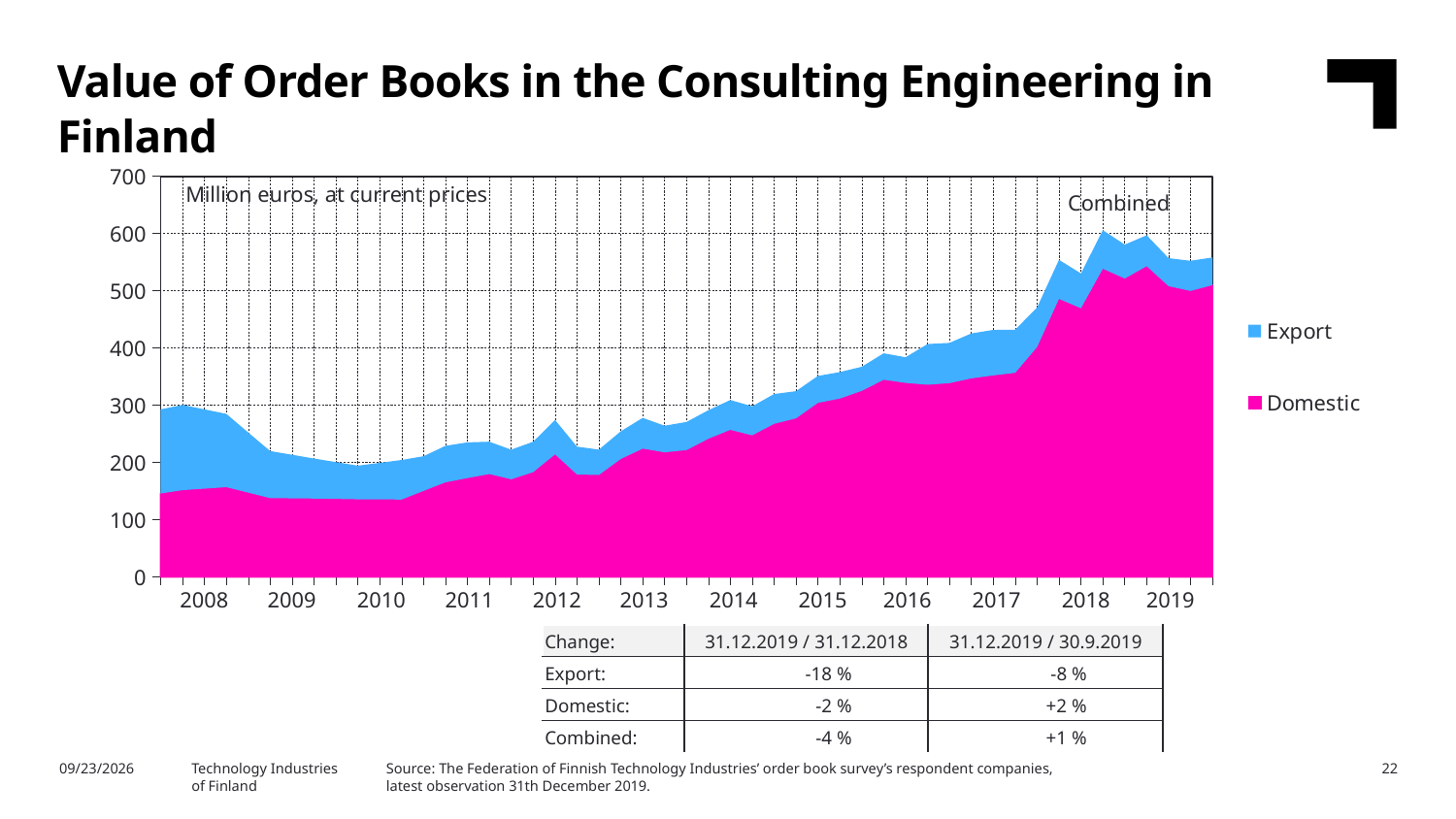
Is the combined value at its 2018 peak greater or less than 500? greater What unit is stated in the chart's label at the top left of the plot area? Million euros, at current prices Does the combined value of order books generally rise or fall from 2008 to 2019? rise Is the Domestic value in 2010 greater or less than 200? less Which two series are listed in the chart legend? Export and Domestic Is the combined value larger at the start of 2008 or at the end of 2019? end of 2019 How many years are labelled on the x axis? 12 Is the combined value at the start of 2008 greater or less than 400? less At the end of 2019, which series is larger, Export or Domestic? Domestic What kind of chart is shown on the slide? area chart How many series does the legend list? 2 In which year does the combined value reach its highest point? 2018